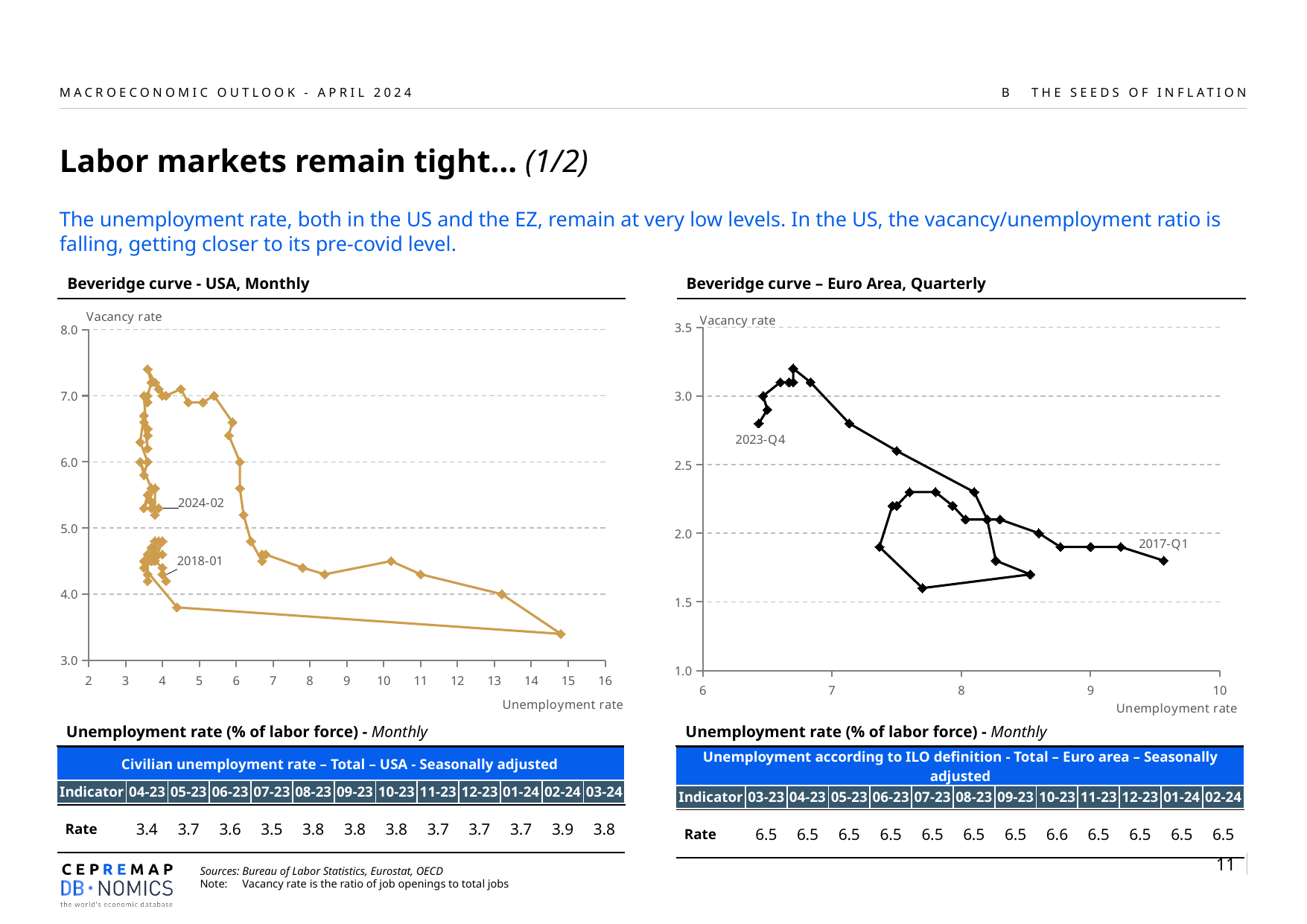
In the 'Beveridge curve - USA, Monthly' chart, which two dates are labelled on the curve? 2024-02 and 2018-01 In the 'Beveridge curve – Euro Area, Quarterly' chart, which labelled point has the higher vacancy rate, 2023-Q4 or 2017-Q1? 2023-Q4 What kind of chart is the 'Beveridge curve - USA, Monthly' chart? Line chart with markers (scatter plot connected by lines) In the 'Beveridge curve - USA, Monthly' chart, is the highest vacancy rate reached greater or less than 8.0? less In the 'Beveridge curve – Euro Area, Quarterly' chart, is the unemployment rate at the point labelled 2017-Q1 greater or less than 9? greater In the 'Beveridge curve - USA, Monthly' chart, is the vacancy rate at the point labelled 2024-02 greater or less than 6.0? less In the 'Beveridge curve - USA, Monthly' chart, what variable is plotted on the vertical axis? Vacancy rate In the 'Beveridge curve – Euro Area, Quarterly' chart, which two quarters are labelled on the curve? 2023-Q4 and 2017-Q1 In the 'Beveridge curve - USA, Monthly' chart, what variable is plotted on the horizontal axis? Unemployment rate